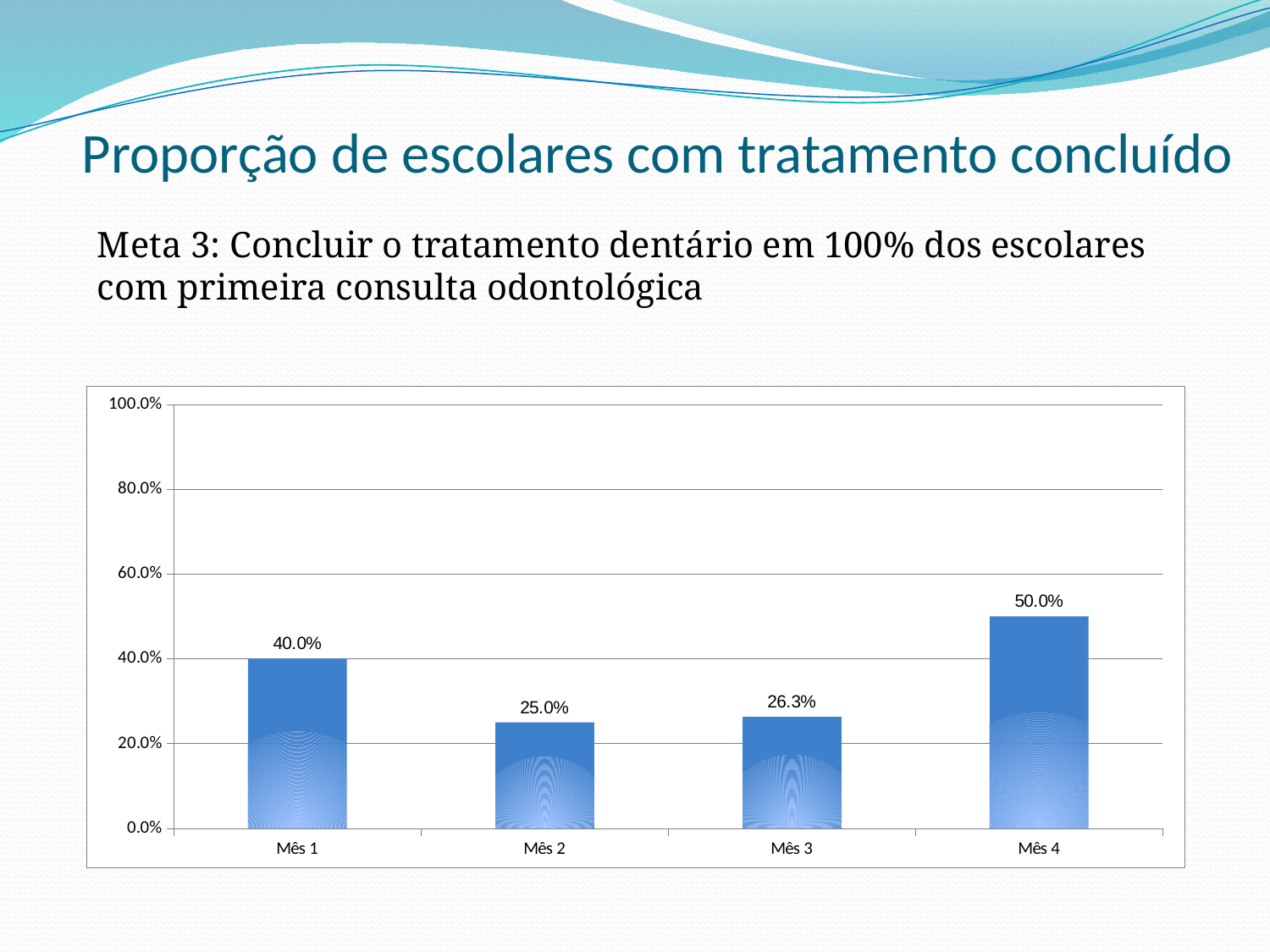
Which month has the lowest value? Mês 2 What is the difference between the values for Mês 3 and Mês 2? 1.3% What is the value for Mês 4? 50.0% Is the value for Mês 4 greater or less than 40.0%? greater How many months are shown on the x axis? 4 Which month has the highest value? Mês 4 What is the value for Mês 1? 40.0% What is the difference between the values for Mês 4 and Mês 1? 10.0% Which is larger, the value for Mês 1 or the value for Mês 3? Mês 1 What is the value for Mês 2? 25.0% What is the value for Mês 3? 26.3% What kind of chart is shown on the slide? bar chart